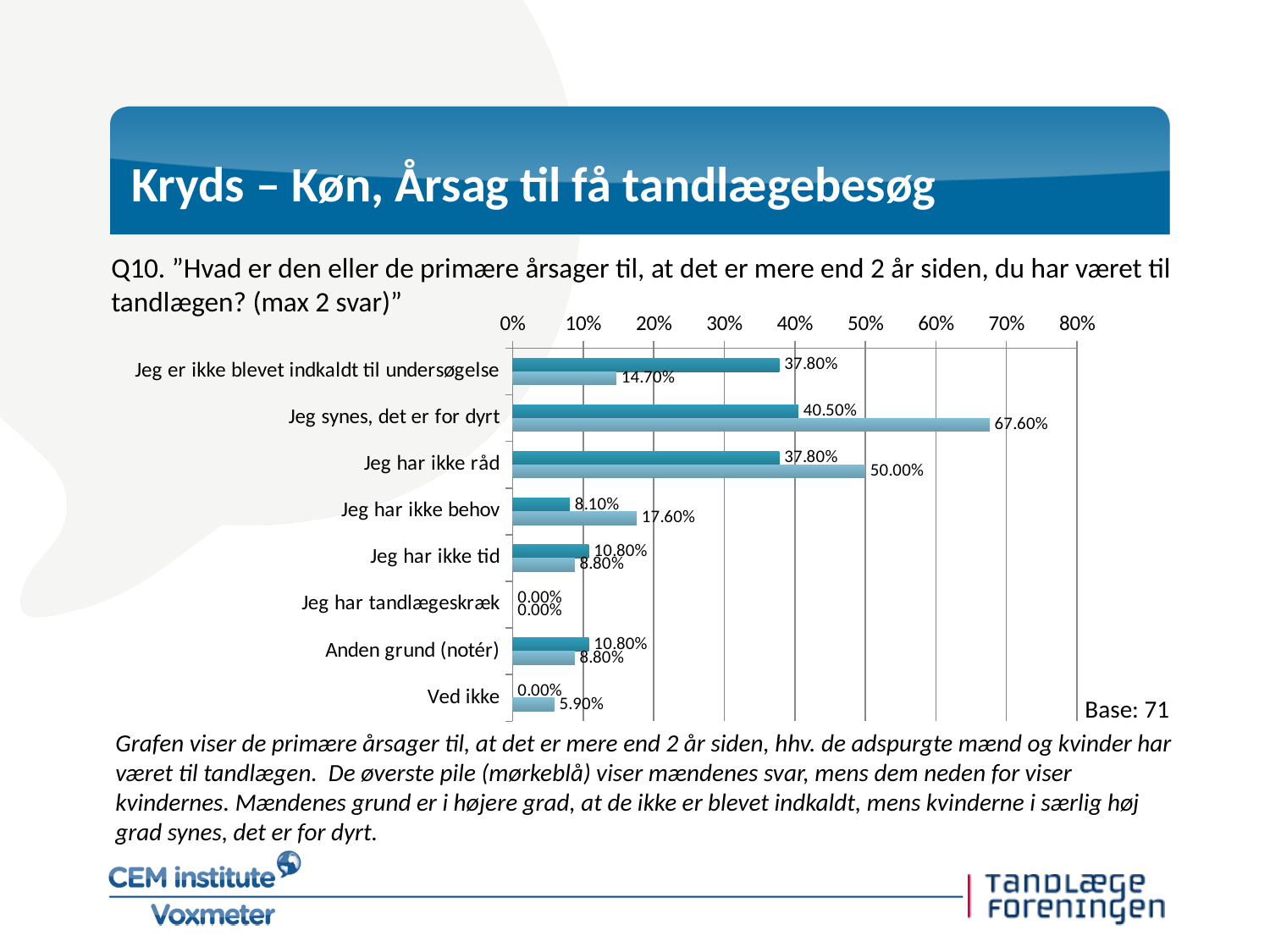
What is the difference between the women's (light blue) and men's (dark blue) values for "Jeg har ikke råd"? 12.20 percentage points How many categories (reasons) are shown on the vertical axis of the chart? 8 What is the base (number of respondents) stated next to the chart? 71 Is the men's (dark blue) value for "Jeg synes, det er for dyrt" greater or less than 50%? less Among the upper (dark blue, men) bars, which category has the highest value? Jeg synes, det er for dyrt What is the value of the lower (light blue, women) bar for "Jeg synes, det er for dyrt"? 67.60% Which category has the highest value of any bar in the chart? Jeg synes, det er for dyrt What kind of chart is shown on the slide? Bar chart What is the value of the lower (light blue, women) bar for "Ved ikke"? 5.90% What is the value of the upper (dark blue, men) bar for "Jeg er ikke blevet indkaldt til undersøgelse"? 37.80% For "Jeg har ikke behov", which is larger: the men's (dark blue) bar or the women's (light blue) bar? The women's (light blue) bar, 17.60% What is the difference between the men's (dark blue) and women's (light blue) values for "Jeg er ikke blevet indkaldt til undersøgelse"? 23.10 percentage points